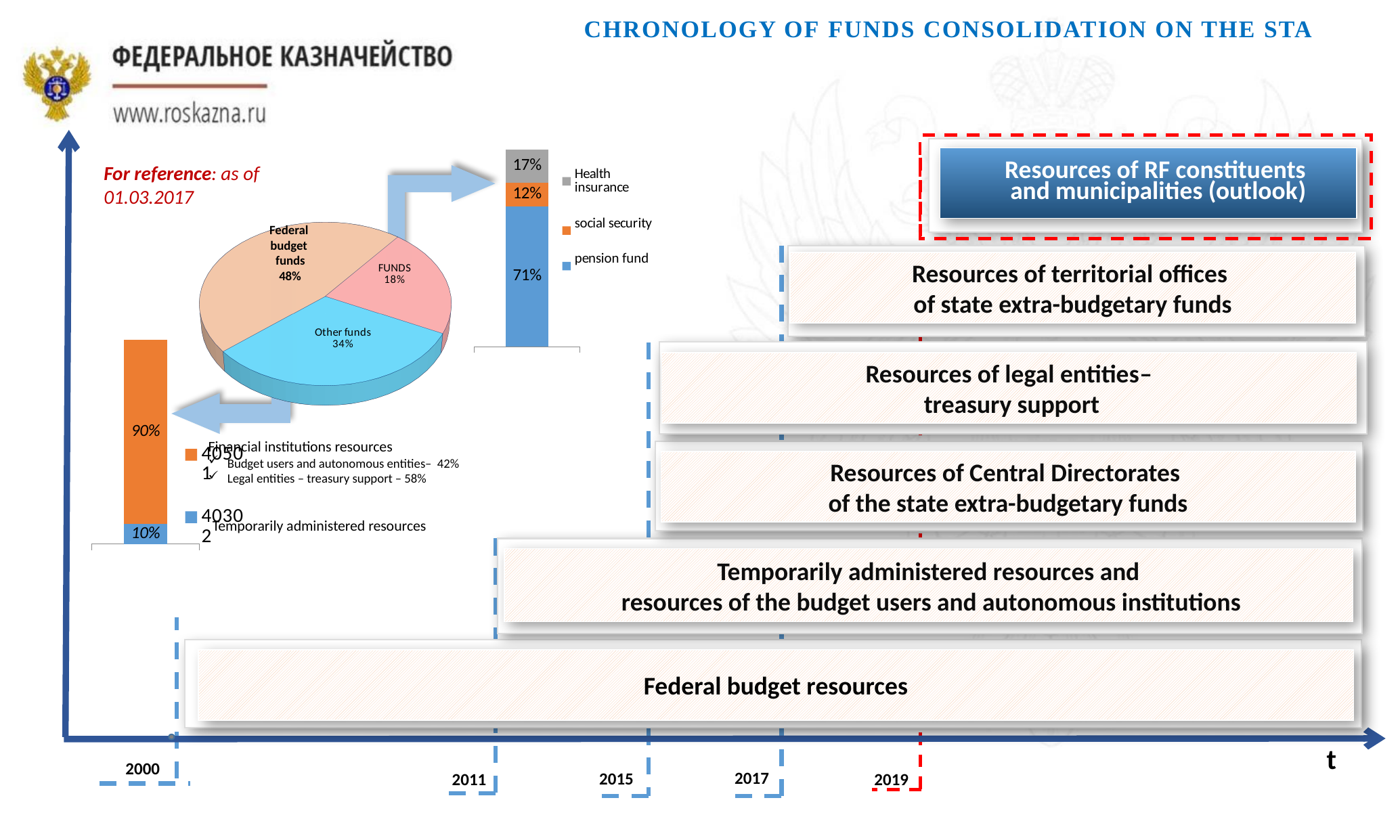
In the pie chart, which slice is the smallest? FUNDS In the pie chart, what share is labelled for FUNDS? 18% In the pie chart, how many slices are there? 3 In the pie chart, what share is labelled for Federal budget funds? 48% In the stacked bar chart at the top centre of the slide, what percentage is shown for Health insurance? 17% In the pie chart, which slice is the largest? Federal budget funds In the stacked bar chart on the left of the slide, which segment is larger: Financial institutions resources or Temporarily administered resources? Financial institutions resources In the stacked bar chart on the left of the slide, what percentage is shown for Temporarily administered resources? 10% In the stacked bar chart at the top centre of the slide, what percentage is shown for the pension fund? 71% In the stacked bar chart at the top centre of the slide, what is the difference between the pension fund and social security percentages? 59% In the stacked bar chart at the top centre of the slide, how many series does the legend list? 3 In the pie chart, what share is labelled for Other funds? 34%